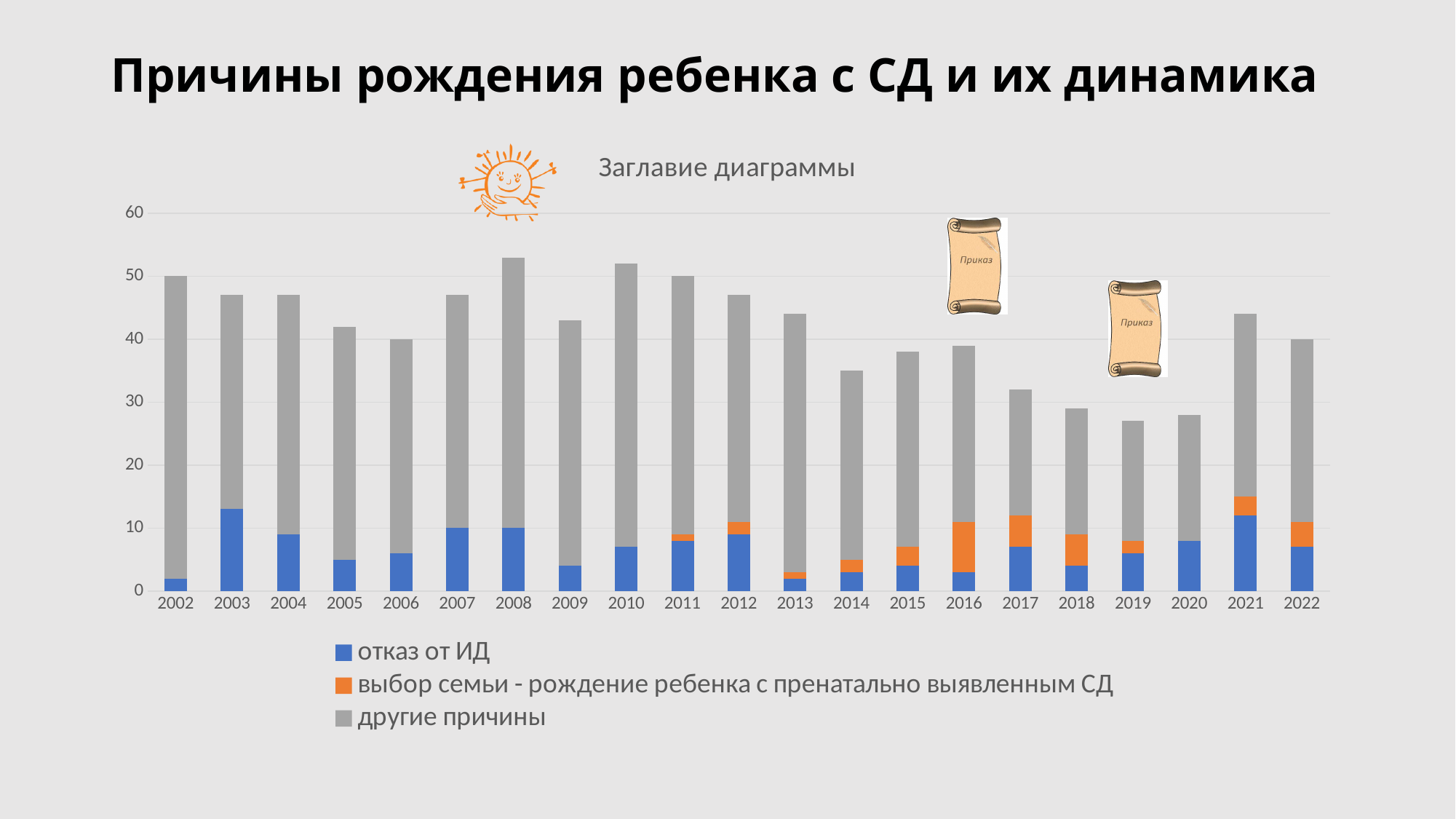
Which bar is taller in total: 2002 or 2019? 2002 Is the total height of the bar for 2019 greater or less than 30? less Which year has the larger 'отказ от ИД' value: 2002 or 2003? 2003 Which colour represents 'другие причины' in the legend? Grey Is the value of 'отказ от ИД' for 2003 greater or less than 10? greater What is the title shown above the chart? Заглавие диаграммы How many years are shown on the x axis of the chart? 21 How many series does the chart legend list? 3 What kind of chart is shown on the slide? Stacked bar chart Is the value of 'отказ от ИД' for 2014 greater or less than 10? less Do the total bar heights rise or fall from 2016 to 2019? fall